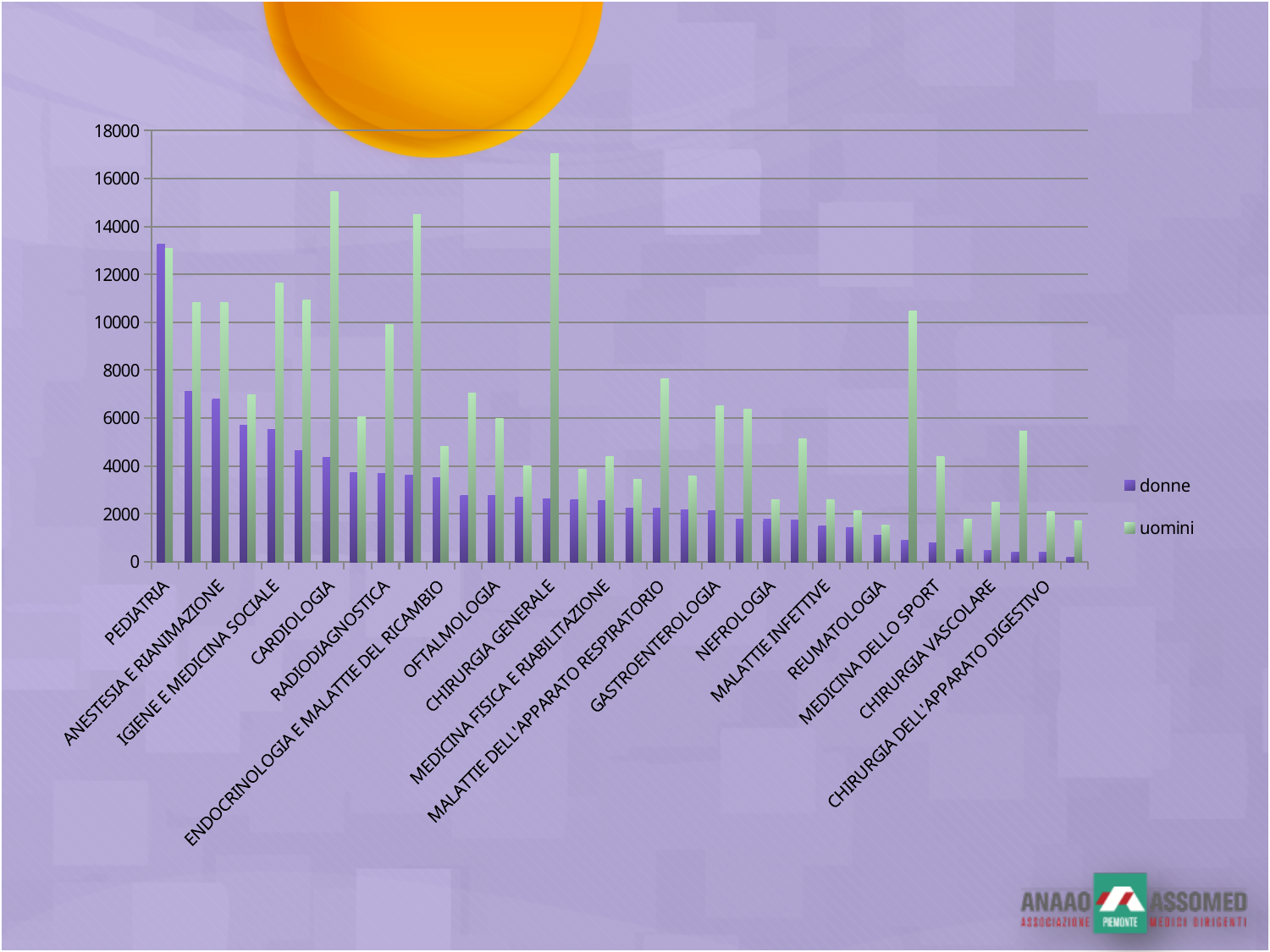
Is the donne value for REUMATOLOGIA greater or less than 2000? less Do the donne values generally rise or fall moving from left to right along the x axis? fall Is the uomini value for CHIRURGIA GENERALE greater or less than 16000? greater Which category has the highest value for the donne series? PEDIATRIA Which category has the highest value for the uomini series? CHIRURGIA GENERALE Is the donne value for PEDIATRIA greater or less than 12000? greater What is the highest value shown on the vertical axis? 18000 Which has the larger uomini value, CARDIOLOGIA or RADIODIAGNOSTICA? CARDIOLOGIA How many series does the legend list? 2 What kind of chart is shown on the slide? bar chart What are the two series named in the legend? donne and uomini For CHIRURGIA GENERALE, which series has the larger value, donne or uomini? uomini